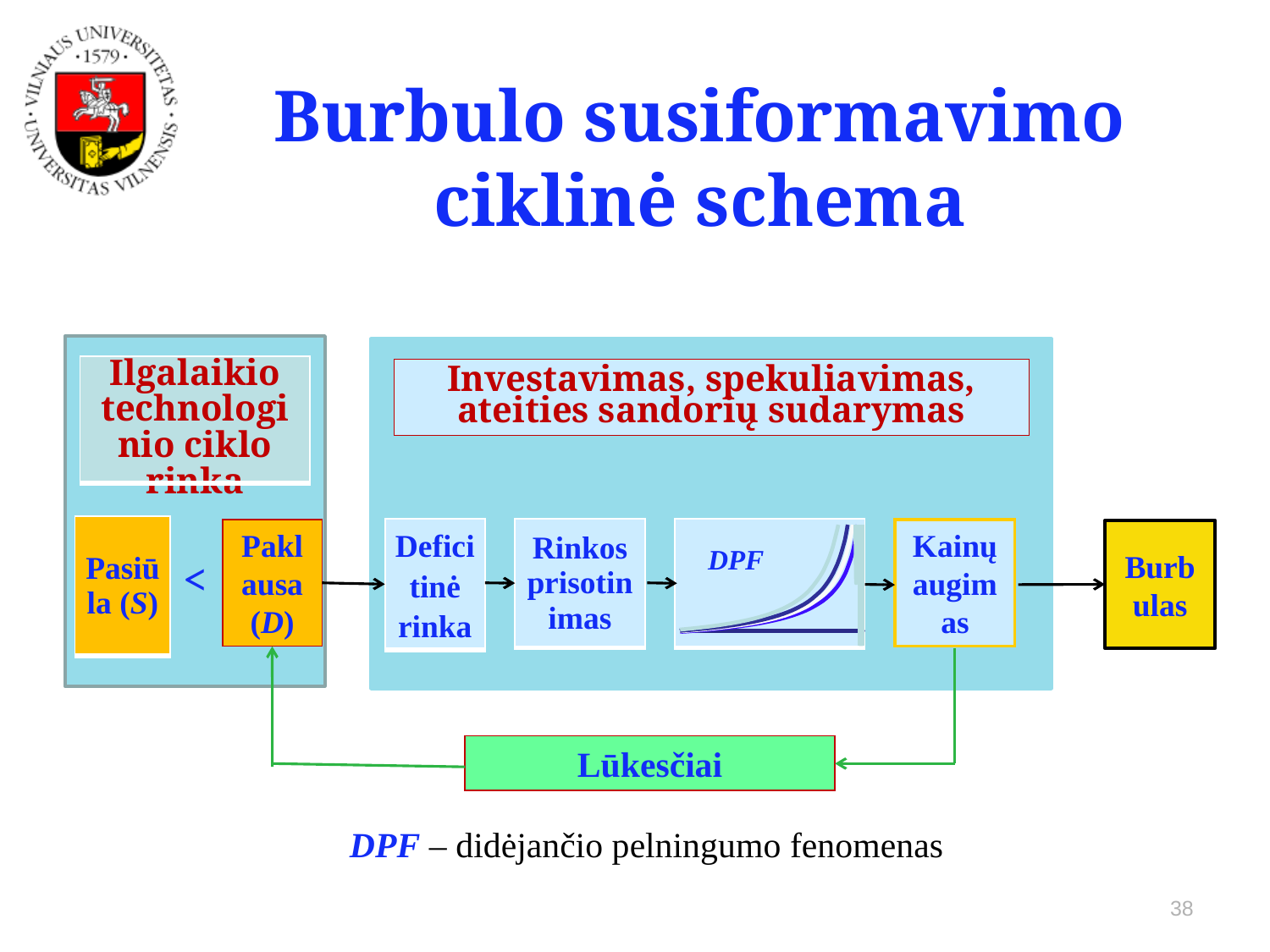
According to the note below the diagram, what does DPF stand for? didėjančio pelningumo fenomenas What kind of chart is shown in the small box labelled DPF in the middle of the diagram? line chart What label is printed inside the small line chart in the middle of the diagram? DPF In the small DPF chart, do the curves rise or fall from left to right? rise